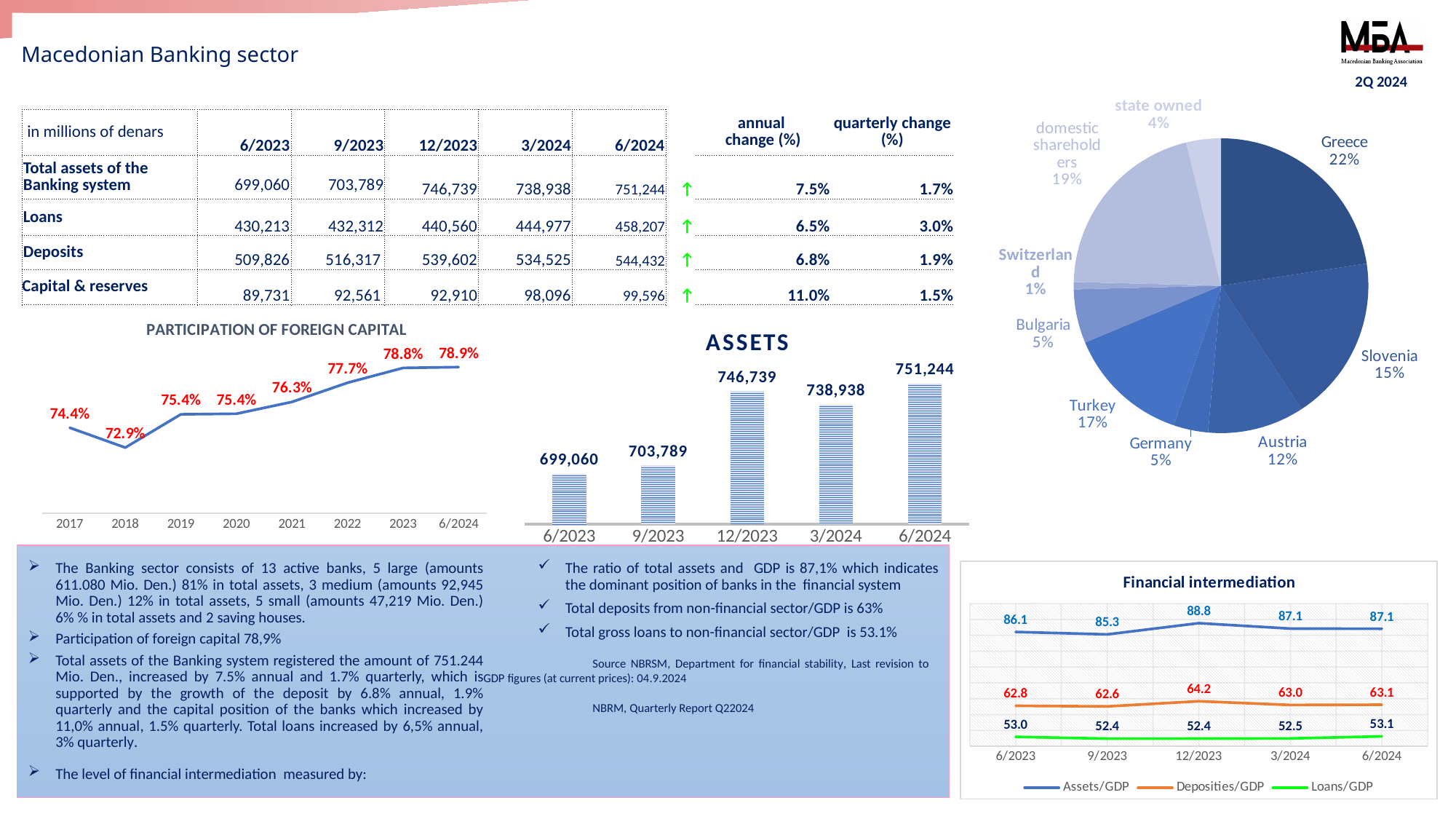
What kind of chart is the ASSETS chart? Bar chart In the pie chart on the right, how many slices are there? 9 How many series does the legend of the Financial intermediation chart list? 3 In the ASSETS chart, which period has the highest value? 6/2024 In the PARTICIPATION OF FOREIGN CAPITAL chart, what is the value for 2018? 72.9% In the pie chart on the right, what share does Greece have? 22% In the ASSETS chart, what is the value for 12/2023? 746,739 In the PARTICIPATION OF FOREIGN CAPITAL chart, which year has the lowest value? 2018 In the pie chart on the right, which slice is the smallest? Switzerland In the Financial intermediation chart, what is the Assets/GDP value for 12/2023? 88.8 In the ASSETS chart, what is the difference between the values for 6/2024 and 6/2023? 52,184 In the PARTICIPATION OF FOREIGN CAPITAL chart, how many data points are plotted? 8